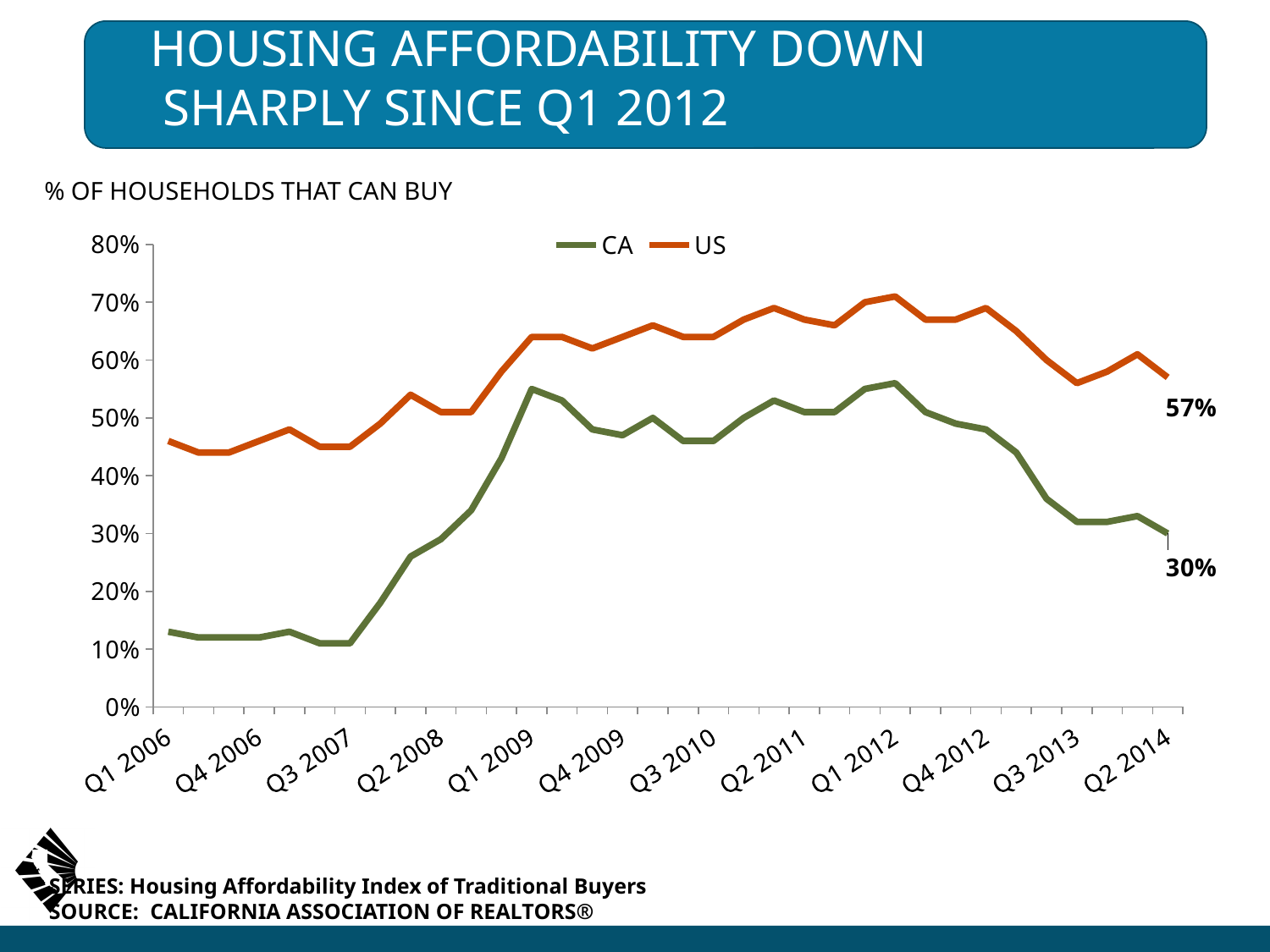
How many series does the legend list? 2 At Q2 2014, which series has the higher value, CA or US? US What is the CA value at Q2 2014? 30% Is the CA value at Q1 2009 greater or less than 50%? greater What kind of chart is shown on the slide? line chart Is the CA value at Q1 2006 greater or less than 20%? less What is the US value at Q2 2014? 57% Which series stays above the other across the whole chart? US What are the two entries in the legend? CA and US What is the difference between the US and CA values at Q2 2014? 27 percentage points Is the US value at Q1 2006 greater or less than 40%? greater Does the CA line rise or fall from Q1 2012 to Q2 2014? fall